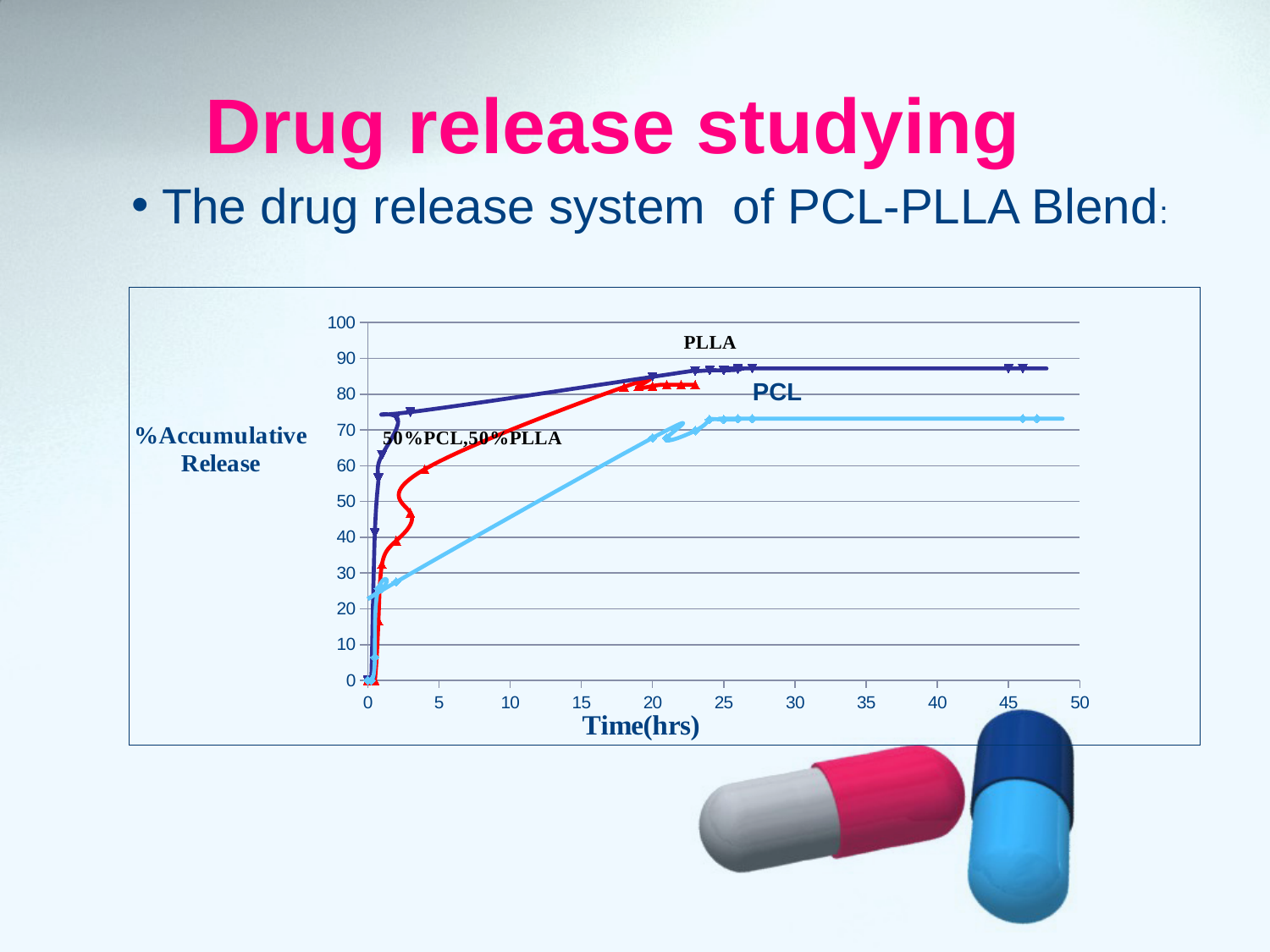
At 20 hrs, which series has the higher %Accumulative Release, 50%PCL,50%PLLA or PCL? 50%PCL,50%PLLA Which series reaches the highest %Accumulative Release at the end of the study (around 45 hrs)? PLLA How many series (curves) are plotted on the chart? 3 Is the %Accumulative Release for PCL at 45 hrs greater or less than 80? less What is the label of the x axis of the chart? Time(hrs) What is the label of the y axis of the chart? %Accumulative Release What kind of chart is shown on the slide? line chart Is the %Accumulative Release for 50%PCL,50%PLLA at 20 hrs greater or less than 90? less Is the %Accumulative Release for PLLA at 45 hrs greater or less than 80? greater At 45 hrs, which series has the higher %Accumulative Release, PLLA or PCL? PLLA Do the %Accumulative Release values rise or fall as Time(hrs) increases? rise Which series has the lowest %Accumulative Release at around 45 hrs? PCL